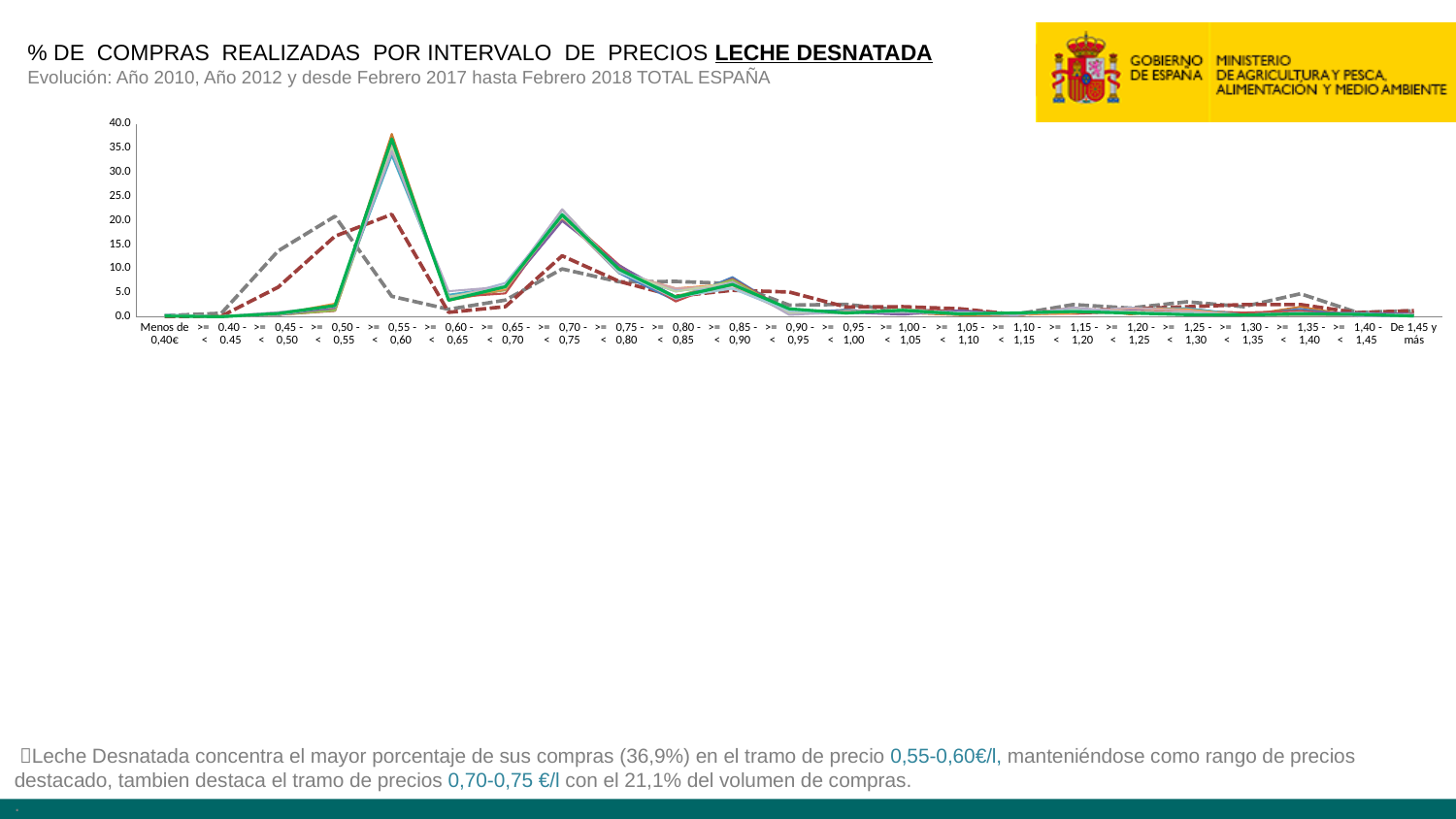
In which price interval do the solid lines reach their highest peak? >= 0,55 - < 0,60 For the solid lines, which interval has the larger value: 0,55 - 0,60 or 0,70 - 0,75? >= 0,55 - < 0,60 Is the peak value of the solid lines at the 0,55 - 0,60 interval greater or less than 30? greater According to the note on the slide, what percentage of skimmed milk purchases falls in the 0,55-0,60 €/l price range? 36,9% Is the value of the solid lines at the 0,45 - 0,50 interval greater or less than 5? less Is the value of the solid lines at the 0,70 - 0,75 interval greater or less than 15? greater Do the solid lines rise or fall between the 0,55 - 0,60 interval and the 0,60 - 0,65 interval? fall For the grey dashed line, which interval has the larger value: 0,50 - 0,55 or 0,55 - 0,60? >= 0,50 - < 0,55 What is the highest value shown on the y axis of the chart? 40.0 What type of chart is shown on the slide? line chart How many price-interval categories are shown along the x axis of the chart? 23